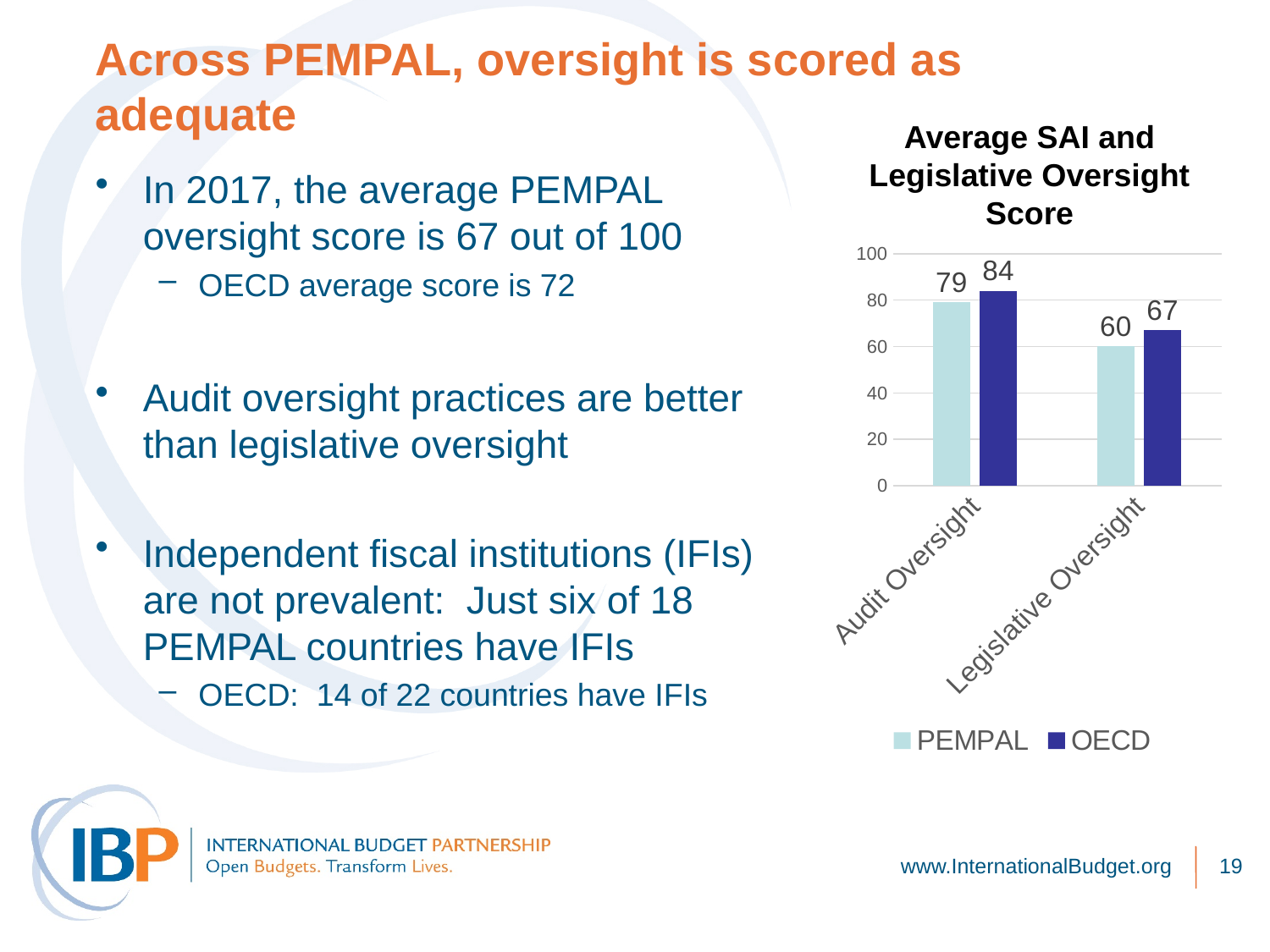
What is the title of the chart? Average SAI and Legislative Oversight Score What is the difference between the OECD and PEMPAL values for Audit Oversight? 5 What is the PEMPAL value for Audit Oversight? 79 What is the PEMPAL value for Legislative Oversight? 60 Which is larger for Legislative Oversight, the PEMPAL value or the OECD value? OECD Which category has the highest OECD value? Audit Oversight Which category has the lowest PEMPAL value? Legislative Oversight How many categories are shown on the x axis? 2 What is the difference between the PEMPAL values for Audit Oversight and Legislative Oversight? 19 How many series does the legend list? 2 What is the OECD value for Legislative Oversight? 67 What kind of chart is shown? Bar chart